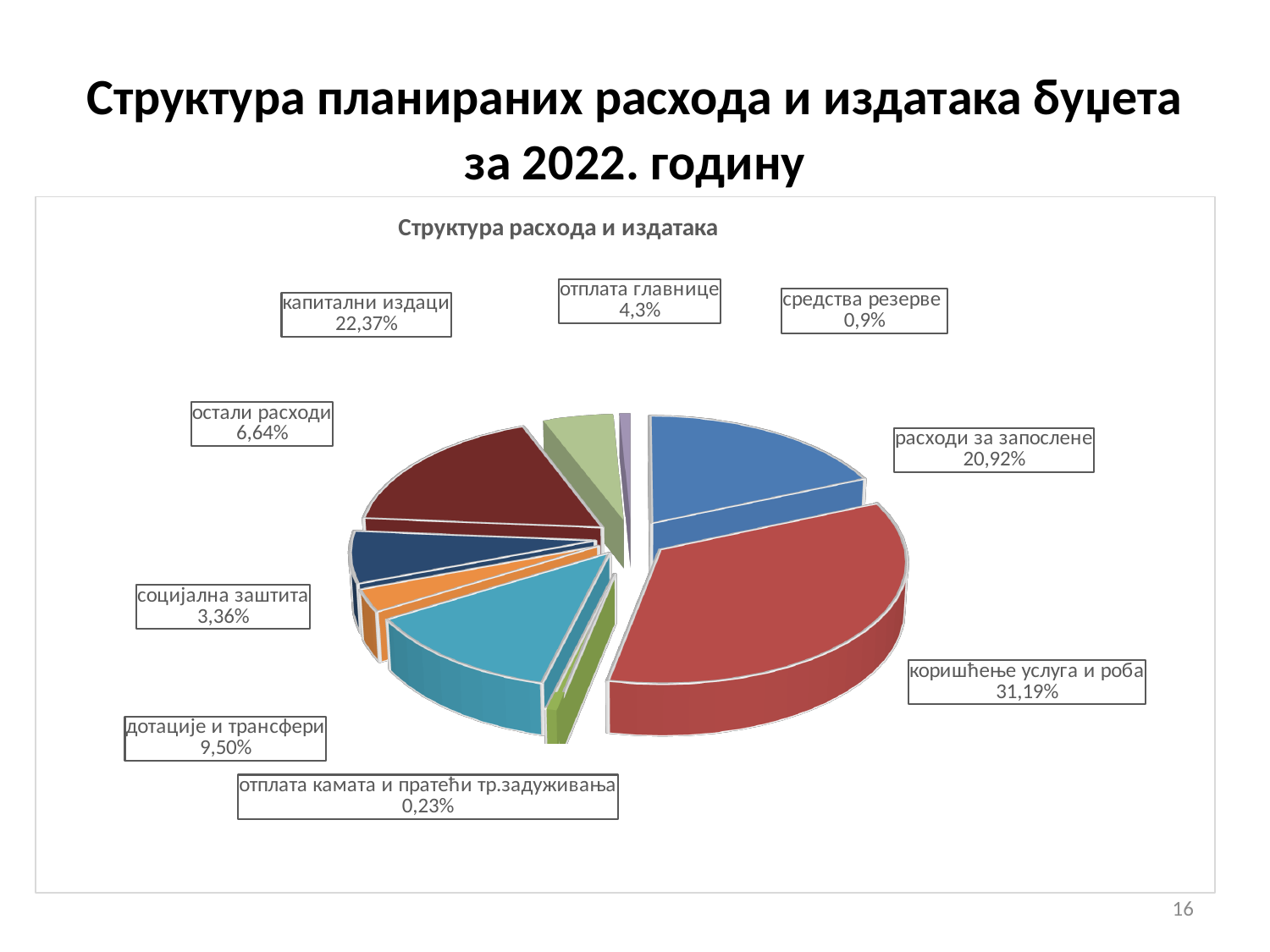
Which category has the largest share of the pie? коришћење услуга и роба What is the title of the chart? Структура расхода и издатака What is the value shown for отплата камата и пратећи тр.задуживања? 0,23% What is the value shown for расходи за запослене? 20,92% What is the difference between the shares for коришћење услуга и роба and расходи за запослене? 10,27% What is the value shown for капитални издаци? 22,37% Which is larger, the share for капитални издаци or the share for расходи за запослене? капитални издаци What kind of chart is shown on the slide? pie chart What share of the pie is labelled for коришћење услуга и роба? 31,19% What is the value shown for дотације и трансфери? 9,50% Which category has the smallest share of the pie? отплата камата и пратећи тр.задуживања How many categories are shown in the pie chart? 9